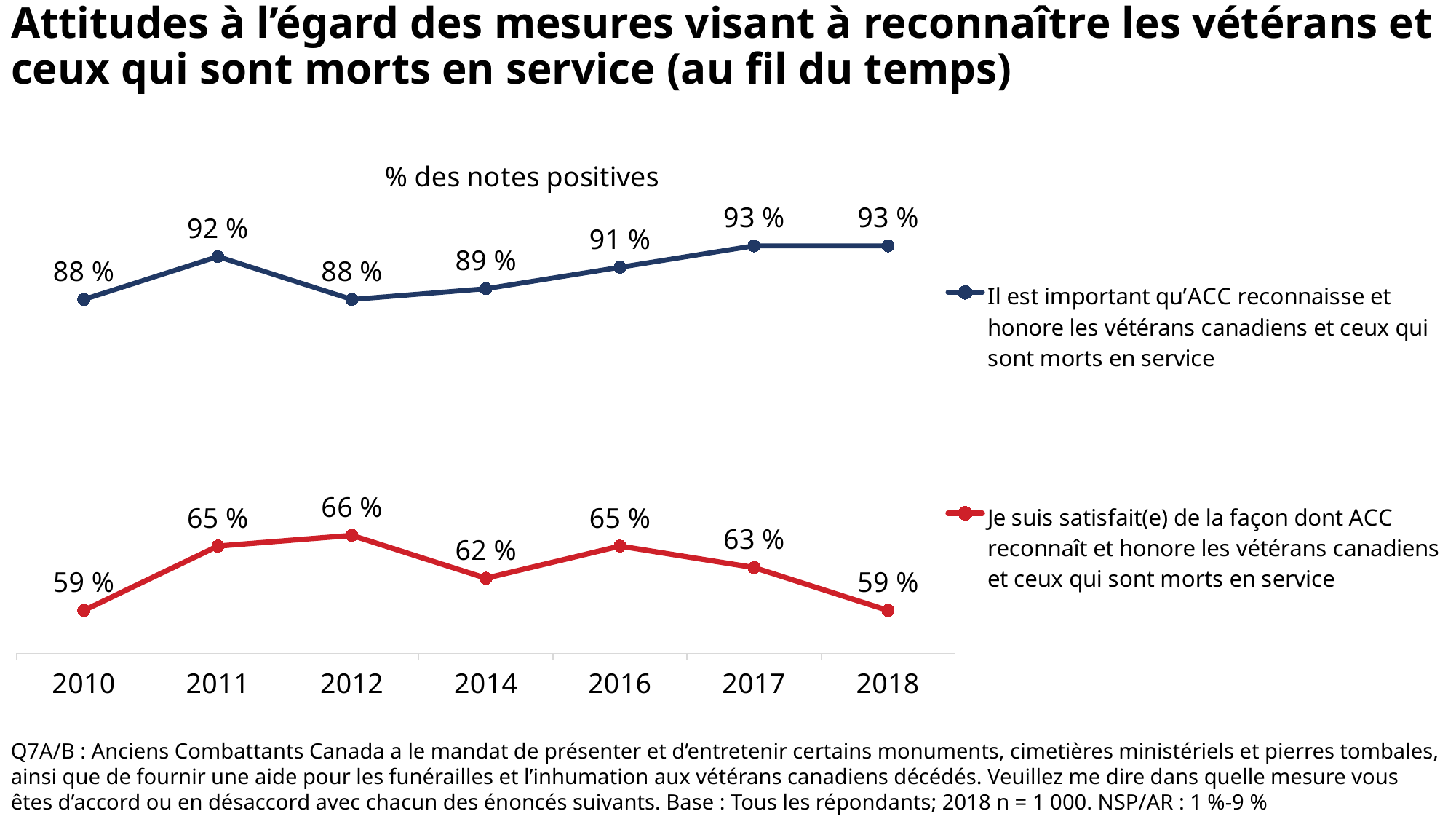
What colour is the line for 'Je suis satisfait(e) de la façon dont ACC reconnaît et honore les vétérans canadiens et ceux qui sont morts en service'? red In which year does the 'Il est important qu'ACC reconnaisse' series have its lowest value? 2010 and 2012 How many series does the legend list? 2 How many years are shown on the x axis? 7 What is the difference between the two series in 2018? 34 % What is the value for 'Je suis satisfait(e) de la façon dont ACC reconnaît et honore les vétérans canadiens et ceux qui sont morts en service' in 2014? 62 % What type of chart is shown on the slide? line chart Which series has the higher value in 2011? Il est important qu'ACC reconnaisse et honore les vétérans canadiens et ceux qui sont morts en service What is the value for 'Il est important qu'ACC reconnaisse et honore les vétérans canadiens et ceux qui sont morts en service' in 2016? 91 % In which year does the 'Je suis satisfait(e)' series reach its highest value? 2012 What is the subtitle shown above the chart? % des notes positives Does the 'Je suis satisfait(e)' series rise or fall from 2017 to 2018? fall